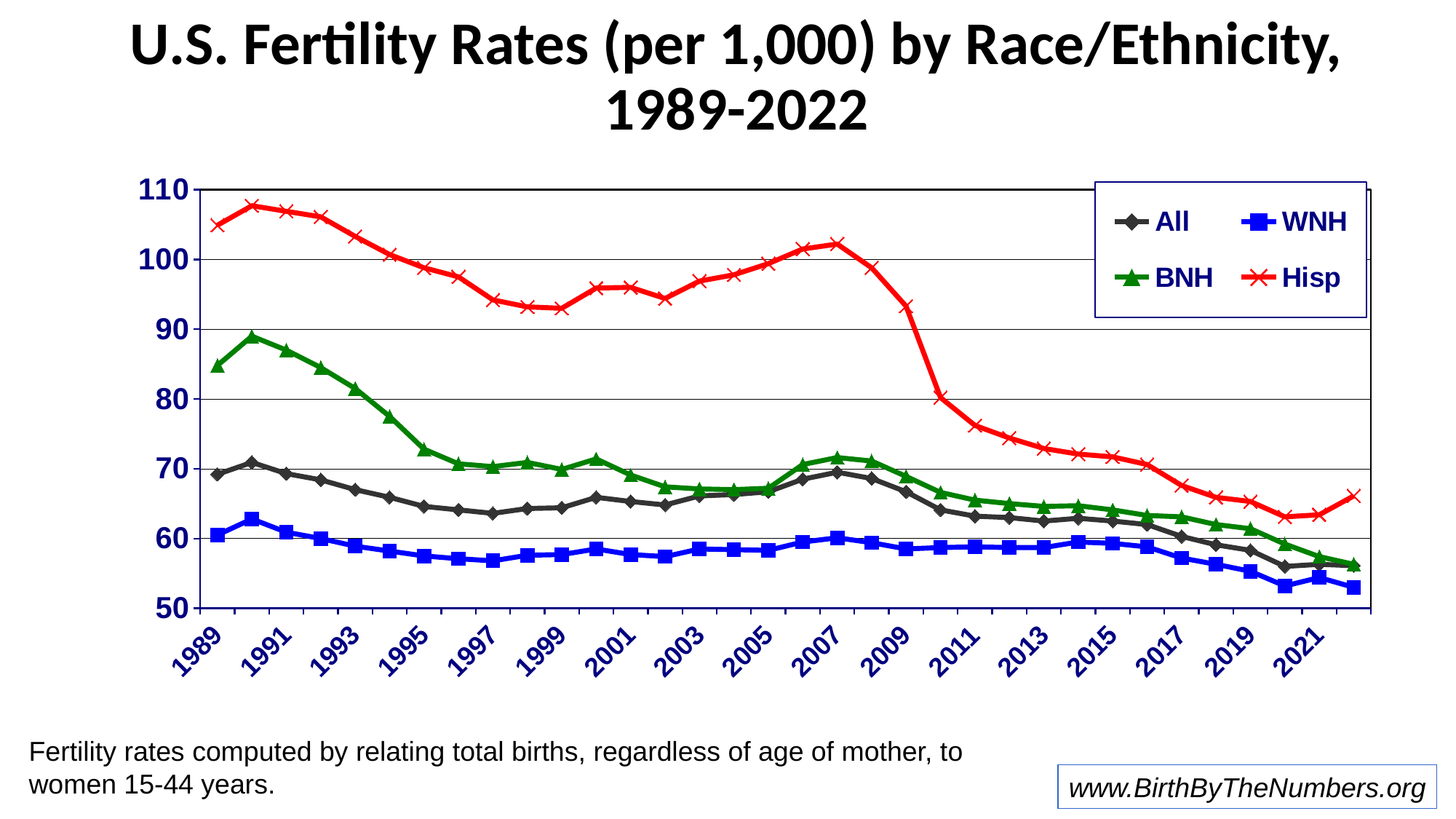
Which series has the lowest fertility rate in 1989? WNH In 2010, which series has the larger value, Hisp or WNH? Hisp How many series does the legend list? 4 Is the Hisp value for 2020 greater or less than 70? less Does the Hisp fertility rate rise or fall from 2007 to 2020? Fall Which series has the highest fertility rate in 1989? Hisp Is the Hisp value for 1989 greater or less than 100? greater What kind of chart is shown on the slide? Line chart Which series is plotted with the red line marked with crosses? Hisp What is the title of the chart? U.S. Fertility Rates (per 1,000) by Race/Ethnicity, 1989-2022 Is the BNH value for 1990 greater or less than 80? greater